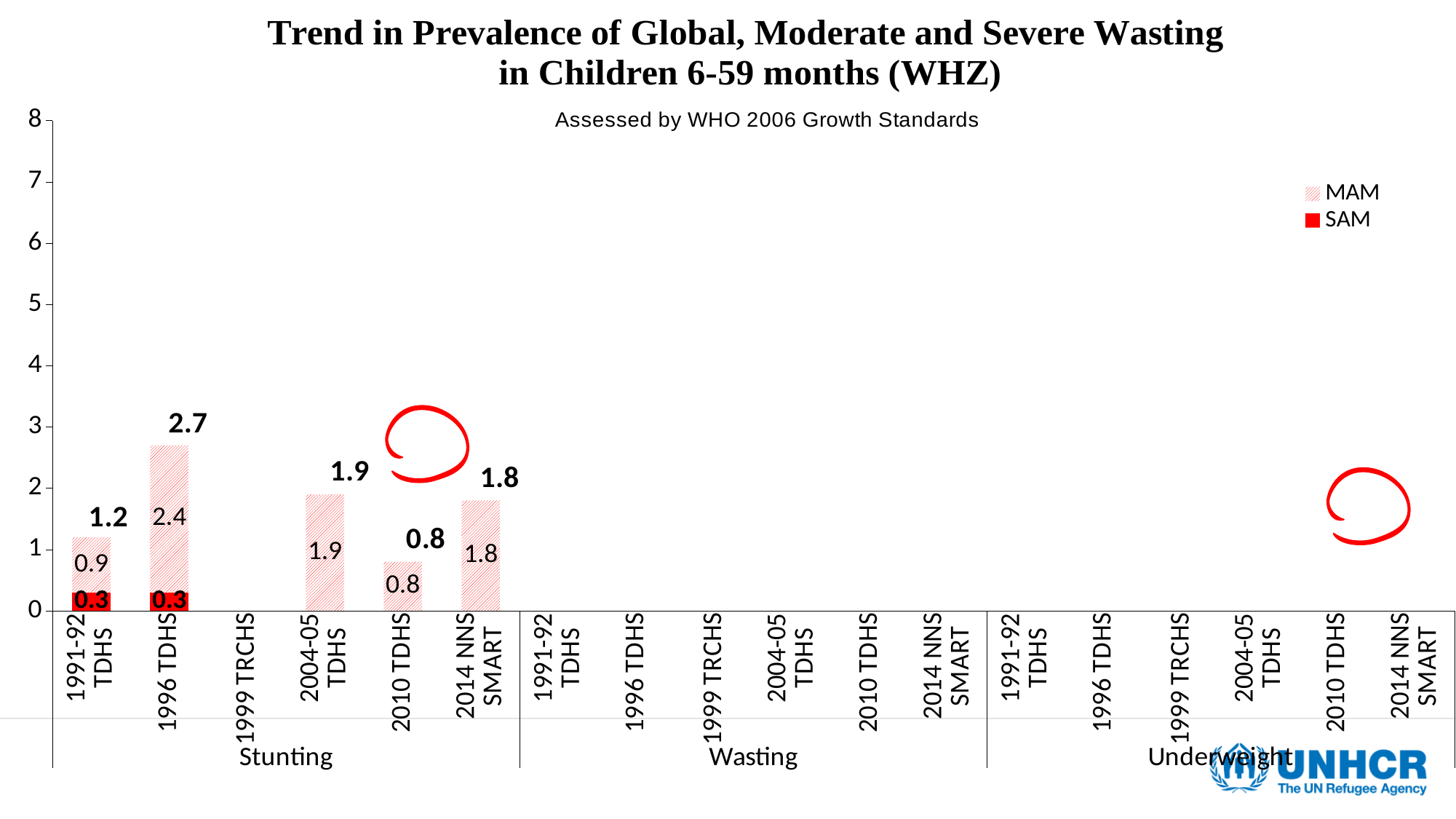
What kind of chart is shown on the slide? stacked bar chart What are the two series named in the legend? MAM and SAM What is the total of the stacked bar for 1996 TDHS in the Stunting group? 2.7 Which survey with a plotted bar in the Stunting group has the lowest total? 2010 TDHS How many series does the legend list? 2 Which survey in the Stunting group has the highest total bar? 1996 TDHS What is the difference between the total for 1996 TDHS and the total for 2014 NNS SMART in the Stunting group? 0.9 What is the SAM value for 1996 TDHS in the Stunting group? 0.3 Which is larger in the Stunting group: the total for 2004-05 TDHS or the total for 2014 NNS SMART? 2004-05 TDHS What is the MAM value for 1991-92 TDHS in the Stunting group? 0.9 What is the MAM value for 2004-05 TDHS in the Stunting group? 1.9 What is the total of the stacked bar for 1991-92 TDHS in the Stunting group? 1.2